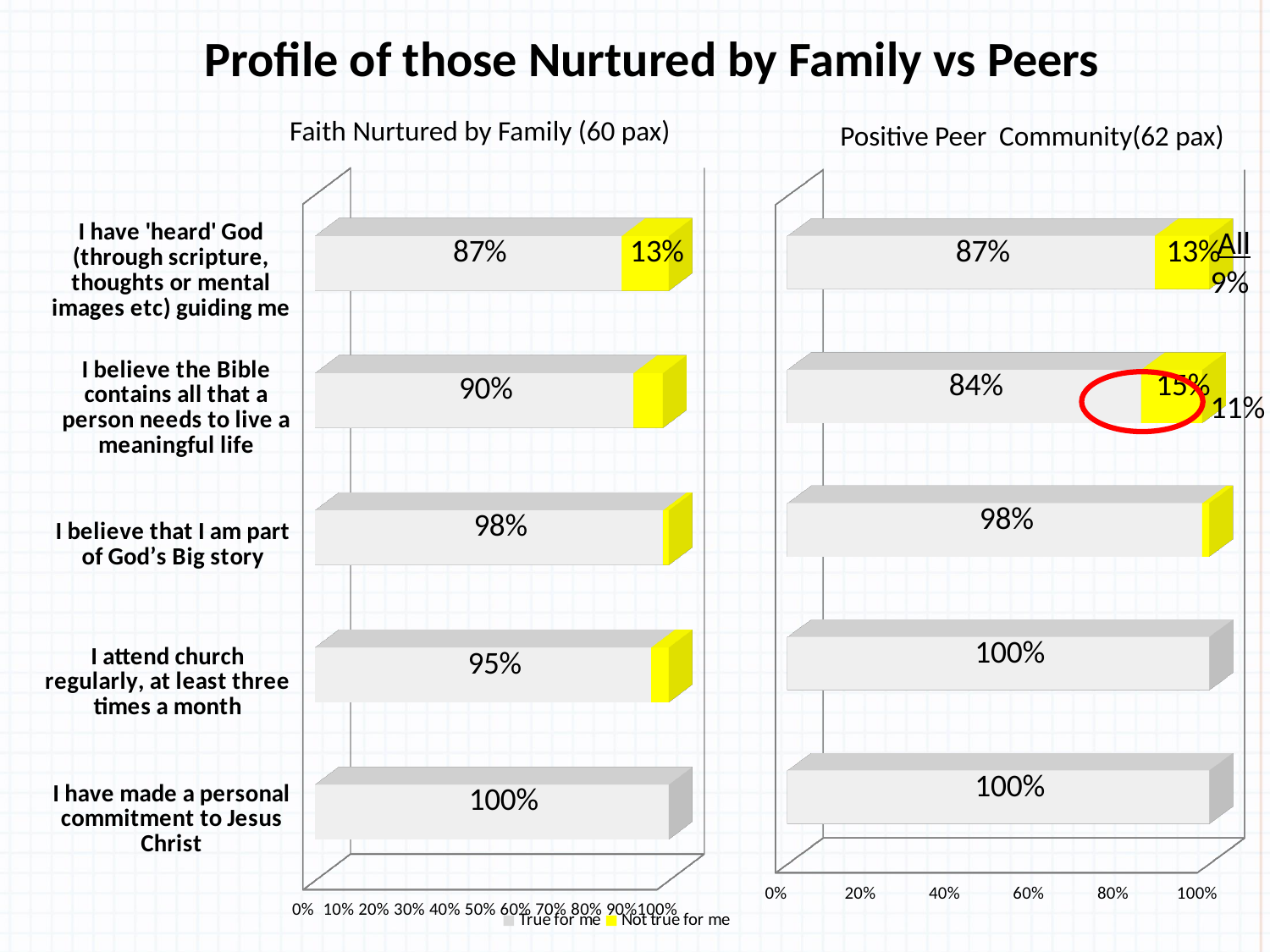
In the 'Positive Peer Community(62 pax)' chart, what percentage answered 'True for me' to 'I believe the Bible contains all that a person needs to live a meaningful life'? 84% In the 'Positive Peer Community(62 pax)' chart, what is the 'True for me' value for 'I attend church regularly, at least three times a month'? 100% In the 'Faith Nurtured by Family (60 pax)' chart, what percentage answered 'True for me' to 'I believe the Bible contains all that a person needs to live a meaningful life'? 90% In the 'Positive Peer Community(62 pax)' chart, what is the 'Not true for me' value for 'I believe the Bible contains all that a person needs to live a meaningful life'? 15% In the 'Faith Nurtured by Family (60 pax)' chart, what is the 'Not true for me' value for 'I have 'heard' God (through scripture, thoughts or mental images etc) guiding me'? 13% Which chart has the larger 'True for me' value for 'I attend church regularly, at least three times a month': 'Faith Nurtured by Family (60 pax)' or 'Positive Peer Community(62 pax)'? Positive Peer Community(62 pax) In the 'Positive Peer Community(62 pax)' chart, which statement has the lowest 'True for me' percentage? I believe the Bible contains all that a person needs to live a meaningful life How many statements (categories) are plotted in the 'Faith Nurtured by Family (60 pax)' chart? 5 In the 'Faith Nurtured by Family (60 pax)' chart, which statement has the lowest 'True for me' percentage? I have 'heard' God (through scripture, thoughts or mental images etc) guiding me What is the difference between the 'True for me' values for 'I believe the Bible contains all that a person needs to live a meaningful life' in the 'Faith Nurtured by Family (60 pax)' chart and the 'Positive Peer Community(62 pax)' chart? 6% What type of chart is the 'Positive Peer Community(62 pax)' chart? Stacked bar chart In the 'Faith Nurtured by Family (60 pax)' chart, what is the 'True for me' value for 'I attend church regularly, at least three times a month'? 95%